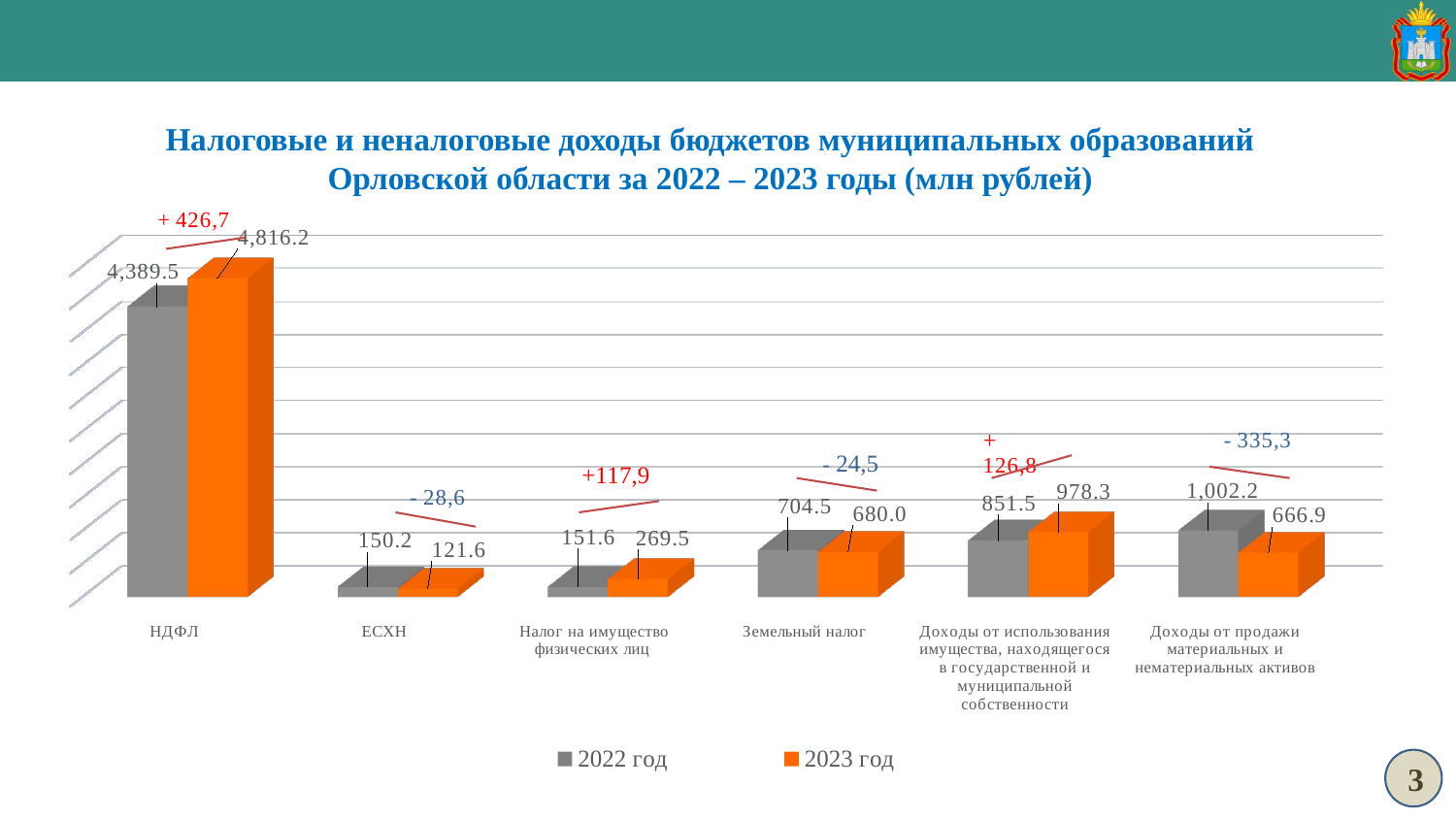
How many series does the legend list? 2 What is the value for Земельный налог in the 2023 год series? 680.0 What is the value for НДФЛ in the 2022 год series? 4,389.5 Which colour represents the 2023 год series? Orange Which category has the highest value in the 2023 год series? НДФЛ How many categories are shown on the x axis? 6 What is the value for ЕСХН in the 2022 год series? 150.2 What is the difference between the 2023 год and 2022 год values for Налог на имущество физических лиц? 117.9 What is the value for НДФЛ in the 2023 год series? 4,816.2 Which is larger for Доходы от продажи материальных и нематериальных активов: the 2022 год value or the 2023 год value? 2022 год Which category has the lowest value in the 2023 год series? ЕСХН What kind of chart is shown on the slide? Bar chart